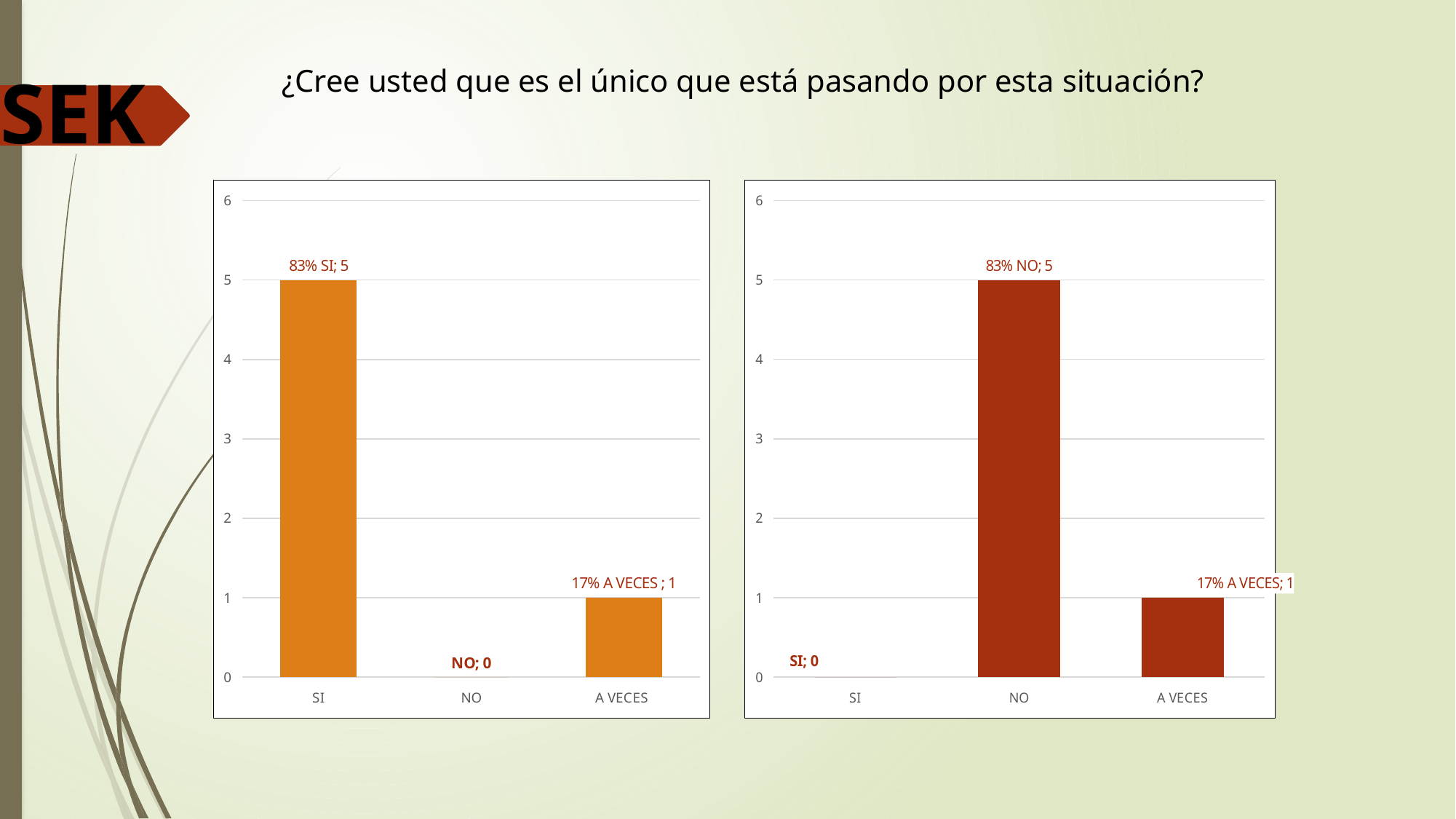
In the right chart, which category has the lowest value? SI In the right chart, what percentage is shown in the data label for A VECES? 17% In the left chart, which category has the highest value? SI In the right chart, what is the value for NO? 5 In the left chart, which is larger, the value for SI or the value for A VECES? SI In the left chart, what is the value for A VECES? 1 In the left chart, what is the value for SI? 5 In the left chart, what is the value for NO? 0 How many categories are shown on the x axis of the right chart? 3 In the right chart, what is the value for SI? 0 In the right chart, what is the difference between the values for NO and A VECES? 4 What kind of chart is the left chart? Bar chart